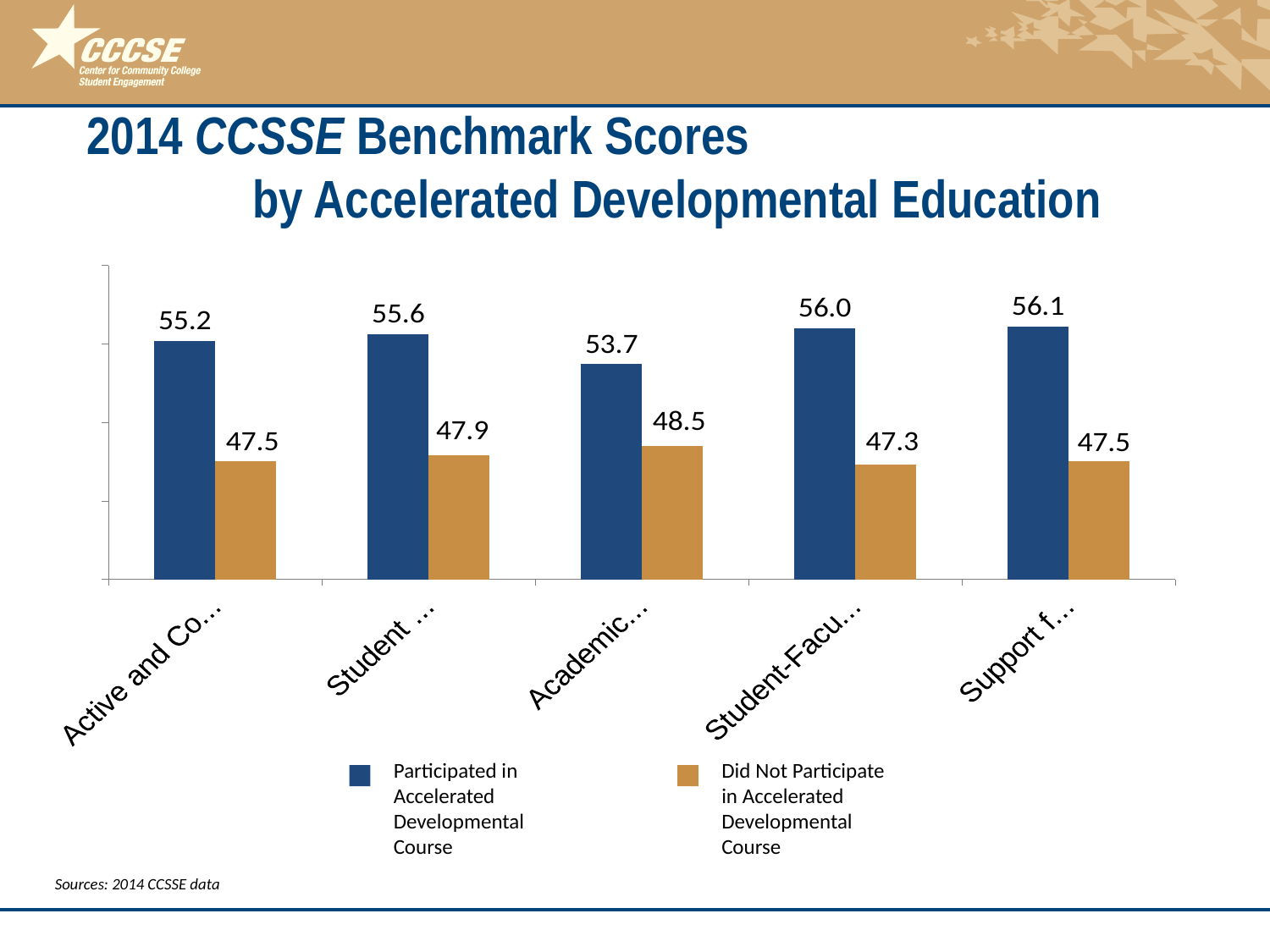
What type of chart is shown on the slide? bar chart What is the value for 'Participated in Accelerated Developmental Course' in the first category from the left (labelled 'Active and Co...')? 55.2 In which category is the 'Did Not Participate in Accelerated Developmental Course' value highest? the third category (Academic...) How many categories are shown along the x axis? 5 Which colour represents 'Did Not Participate in Accelerated Developmental Course' in the legend? gold/tan In which category is the 'Participated in Accelerated Developmental Course' value lowest? the third category (Academic...) What is the value for 'Did Not Participate in Accelerated Developmental Course' in the fourth category from the left (labelled 'Student-Facu...')? 47.3 How many series does the legend list? 2 What is the value for 'Did Not Participate in Accelerated Developmental Course' in the third category from the left (labelled 'Academic...')? 48.5 In the third category from the left (Academic...), which series has the larger value? Participated in Accelerated Developmental Course What is the value for 'Participated in Accelerated Developmental Course' in the fifth category from the left (labelled 'Support f...')? 56.1 What is the difference between the 'Participated' and 'Did Not Participate' values in the first category from the left (Active and Co...)? 7.7